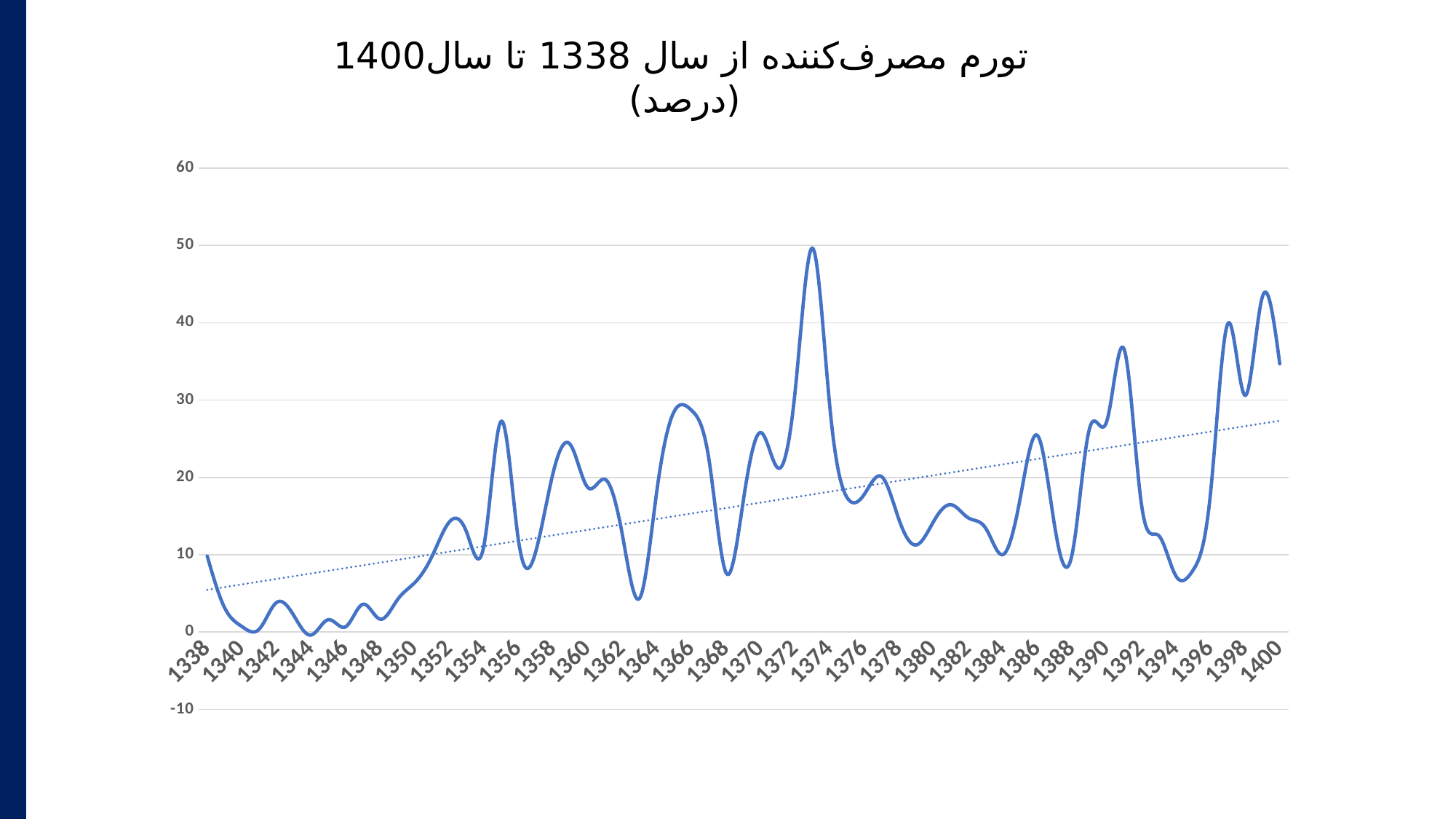
What kind of chart is shown on the slide? line chart What is the first year labelled on the x axis? 1338 Which has the larger value, 1400 or 1338? 1400 Is the highest value on the line greater or less than 40? greater Which has the larger value, 1366 or 1344? 1366 Is the value for 1356 greater or less than 20? less Does the dotted trend line rise or fall from 1338 to 1400? rise Is the value for 1394 greater or less than 10? less What is the title of the chart? تورم مصرف‌کننده از سال 1338 تا سال 1400 (درصد)